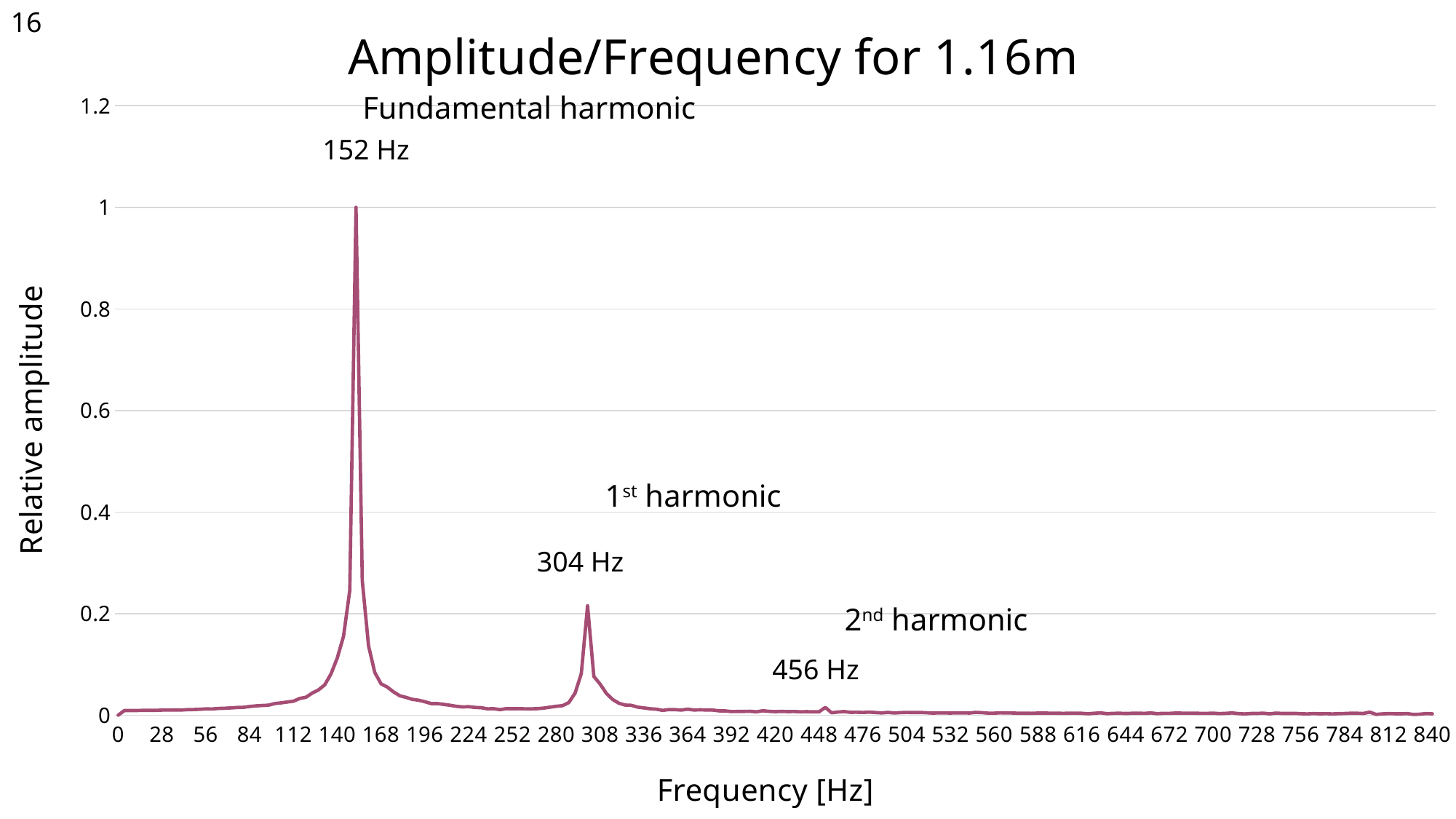
Is the relative amplitude of the 2nd harmonic peak at 456 Hz greater or less than 0.2? less At what frequency is the 1st harmonic labelled? 304 Hz Which labelled harmonic has the highest relative amplitude? Fundamental harmonic (152 Hz) At what frequency is the fundamental harmonic labelled? 152 Hz Which has the larger relative amplitude, the 1st harmonic peak or the 2nd harmonic peak? 1st harmonic What is the title of the chart? Amplitude/Frequency for 1.16m How many harmonics are labelled on the chart? 3 At what frequency is the 2nd harmonic labelled? 456 Hz Is the relative amplitude of the 1st harmonic peak at 304 Hz greater or less than 0.4? less What relative amplitude does the peak at 152 Hz reach? 1 What kind of chart is shown on the slide? line chart What is the label of the vertical axis? Relative amplitude